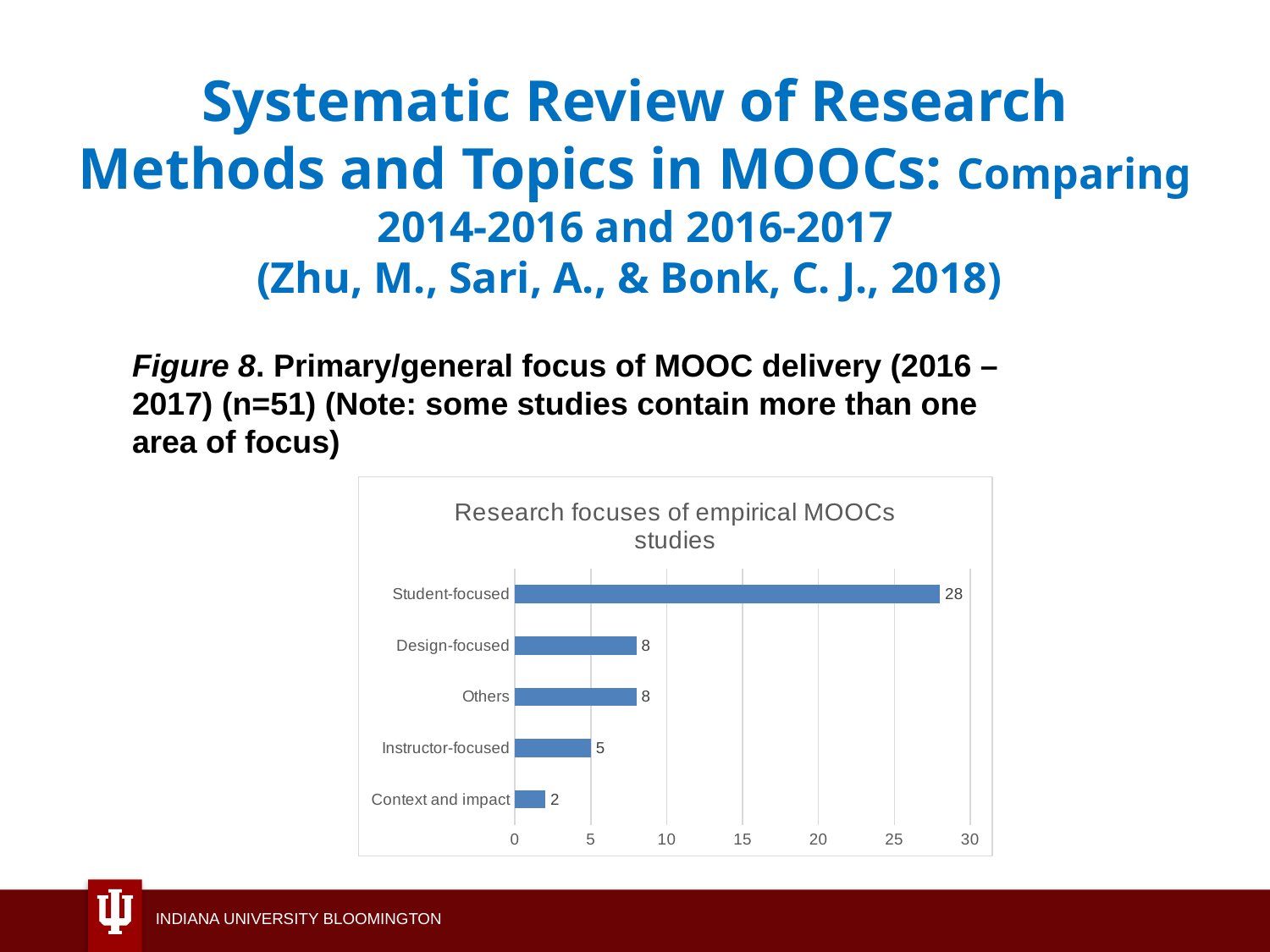
What is the value for Student-focused? 28 What is the difference between the values for Student-focused and Design-focused? 20 What is the difference between the values for Instructor-focused and Context and impact? 3 What is the value for Context and impact? 2 Is the value for Student-focused greater or less than 25? greater Which category has the lowest value? Context and impact How many categories are shown in the chart? 5 What is the value for Instructor-focused? 5 Which category has the highest value? Student-focused What is the title of the chart? Research focuses of empirical MOOCs studies What kind of chart is shown on the slide? bar chart Which is larger, the value for Design-focused or the value for Instructor-focused? Design-focused